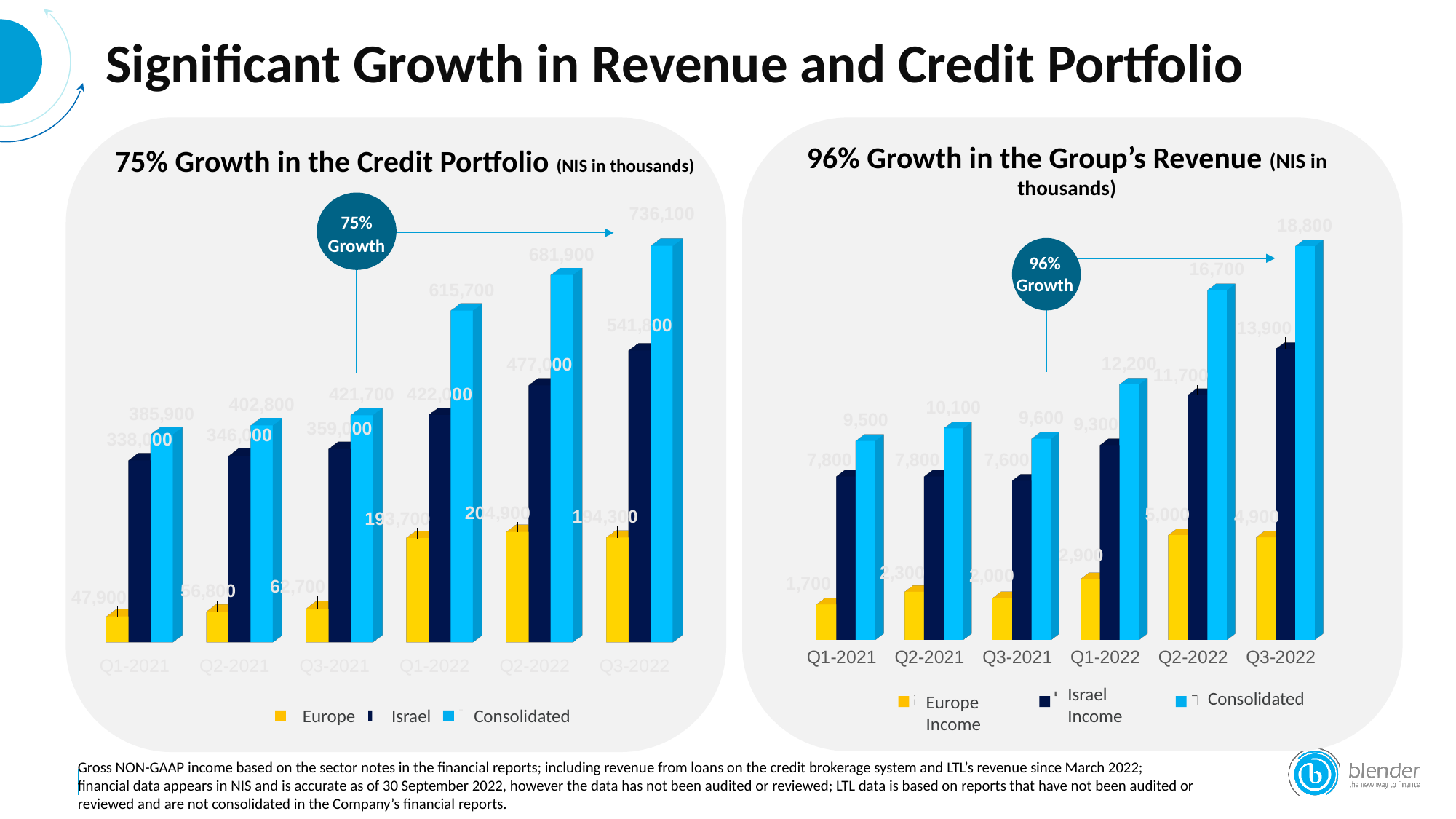
In the '75% Growth in the Credit Portfolio' chart, what is the Europe value for Q1-2021? 47,900 In the '75% Growth in the Credit Portfolio' chart, which quarter has the highest Consolidated value? Q3-2022 What type of chart is the '96% Growth in the Group's Revenue' chart? Bar chart In the '96% Growth in the Group's Revenue' chart, how many series does the legend list? 3 In the '75% Growth in the Credit Portfolio' chart, what is the difference between the Consolidated values for Q3-2022 and Q1-2021? 350,200 In the '75% Growth in the Credit Portfolio' chart, what is the Consolidated value for Q3-2022? 736,100 In the '96% Growth in the Group's Revenue' chart, which quarter has the lowest Consolidated value? Q1-2021 In the '96% Growth in the Group's Revenue' chart, what is the Europe Income value for Q1-2021? 1,700 In the '96% Growth in the Group's Revenue' chart, what is the Israel Income value for Q2-2022? 11,700 In the '75% Growth in the Credit Portfolio' chart, what is the Consolidated value for Q1-2021? 385,900 In the '75% Growth in the Credit Portfolio' chart, how many quarters are shown on the x axis? 6 In the '96% Growth in the Group's Revenue' chart, what is the Consolidated value for Q3-2022? 18,800